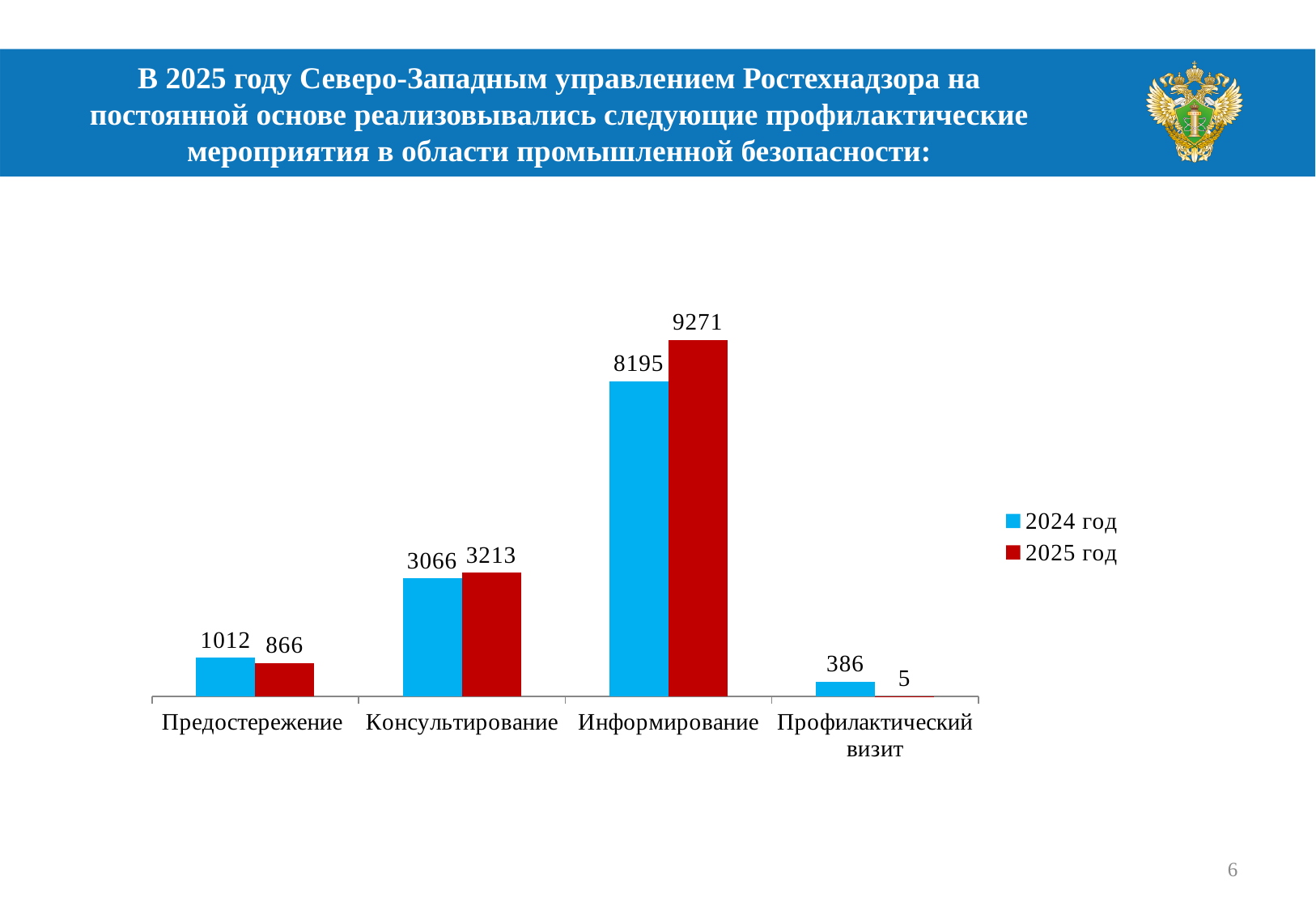
How many categories are shown on the x axis? 4 What kind of chart is shown on the slide? Bar chart Which category has the lowest value in the 2024 год series? Профилактический визит Which is larger for Консультирование: the 2024 год value or the 2025 год value? 2025 год Which category has the highest value in the 2025 год series? Информирование What is the value for Профилактический визит in the 2025 год series? 5 What is the value for Предостережение in the 2024 год series? 1012 What is the difference between the 2025 год and 2024 год values for Информирование? 1076 What is the value for Консультирование in the 2024 год series? 3066 How many series does the legend list? 2 What is the difference between the 2024 год and 2025 год values for Предостережение? 146 What is the value for Информирование in the 2025 год series? 9271